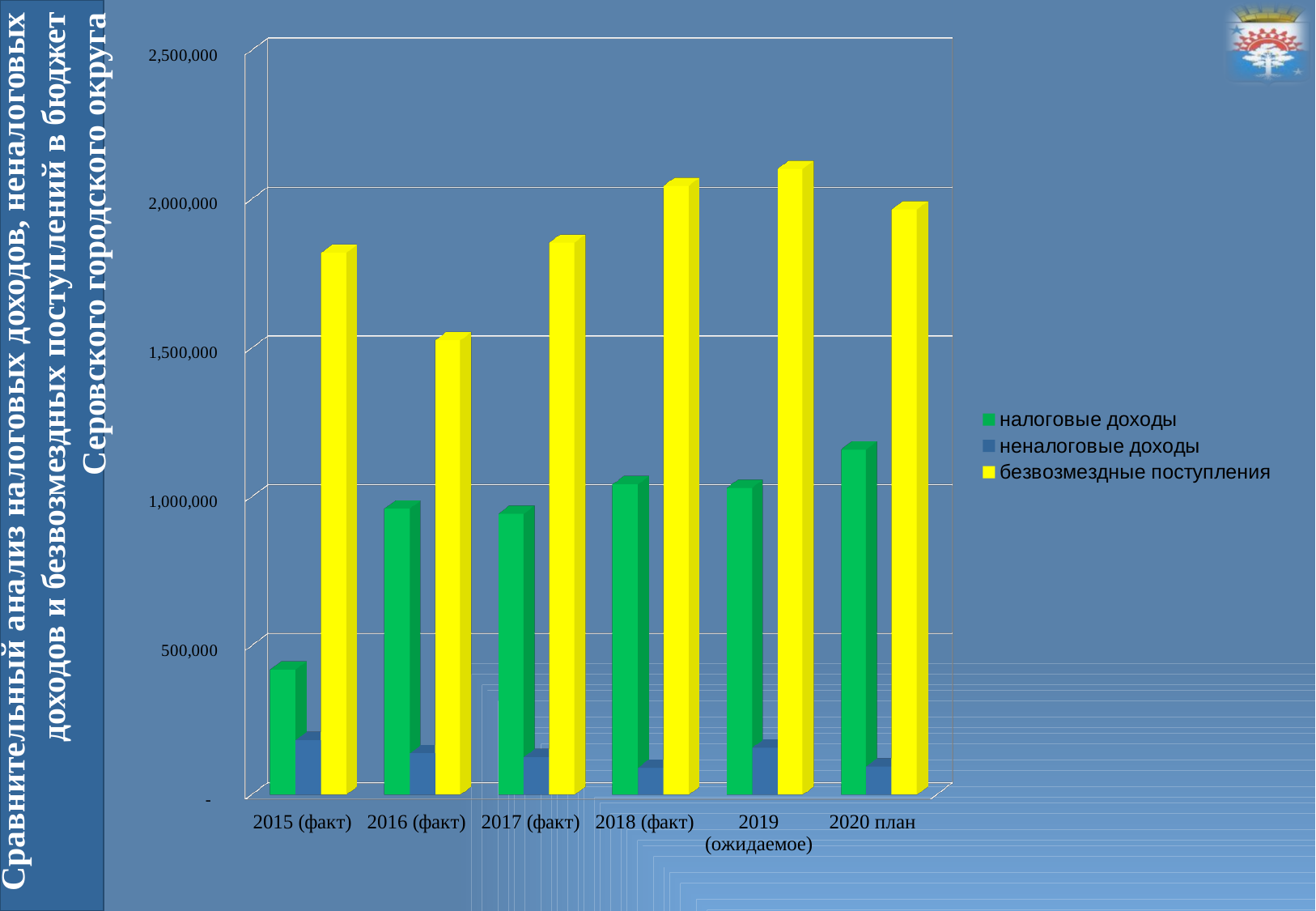
In which year is the value for налоговые доходы the lowest? 2015 (факт) What kind of chart is shown on the slide? bar chart Is the value for налоговые доходы in 2015 (факт) greater or less than 500,000? less Is the value for безвозмездные поступления in 2019 (ожидаемое) greater or less than 2,000,000? greater In which year is the value for налоговые доходы the highest? 2020 план In which year is the value for безвозмездные поступления the lowest? 2016 (факт) How many series does the legend list? 3 In which year is the value for безвозмездные поступления the highest? 2019 (ожидаемое) Is the value for налоговые доходы in 2020 план greater or less than 1,000,000? greater Which colour represents безвозмездные поступления in the legend? yellow How many year categories are shown on the x axis? 6 Which is larger: налоговые доходы in 2015 (факт) or налоговые доходы in 2016 (факт)? 2016 (факт)